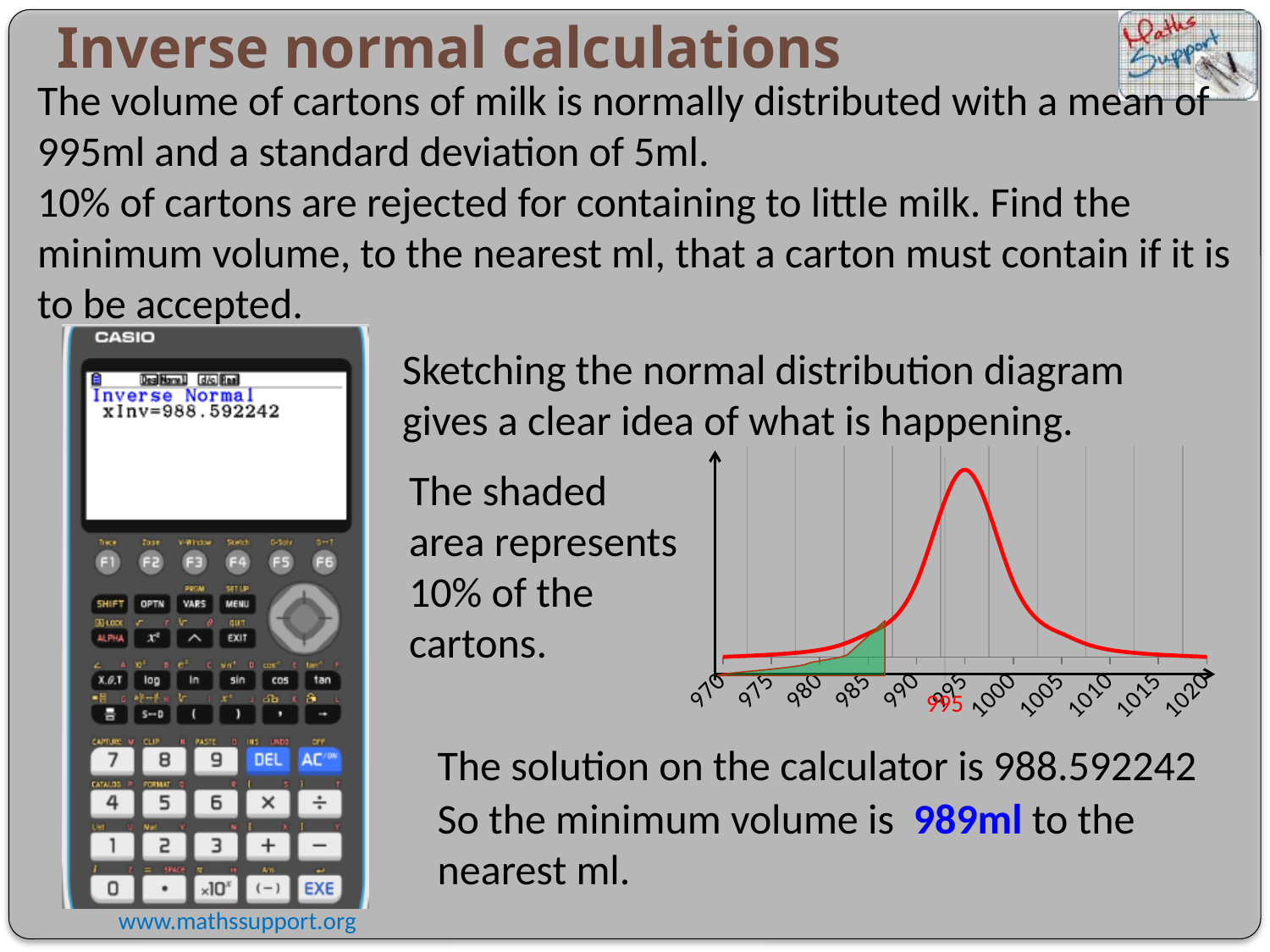
According to the slide, what percentage of cartons does the shaded area represent? 10% What colour is the distribution curve drawn in? red What is the lowest value labelled on the x axis? 970 Does the curve rise or fall as x increases from 970 to 995? rises Is the shaded region to the left or to the right of the peak of the curve? left What is the spacing between consecutive tick labels on the x axis? 5 Is the right-hand boundary of the shaded region greater or less than 990? less What is the highest value labelled on the x axis? 1020 At which x-axis value does the curve reach its peak? 995 How many labelled tick values are there on the x axis of the chart? 11 What kind of chart is shown on the slide? a line chart (normal distribution curve) Does the curve rise or fall as x increases from 995 to 1020? falls